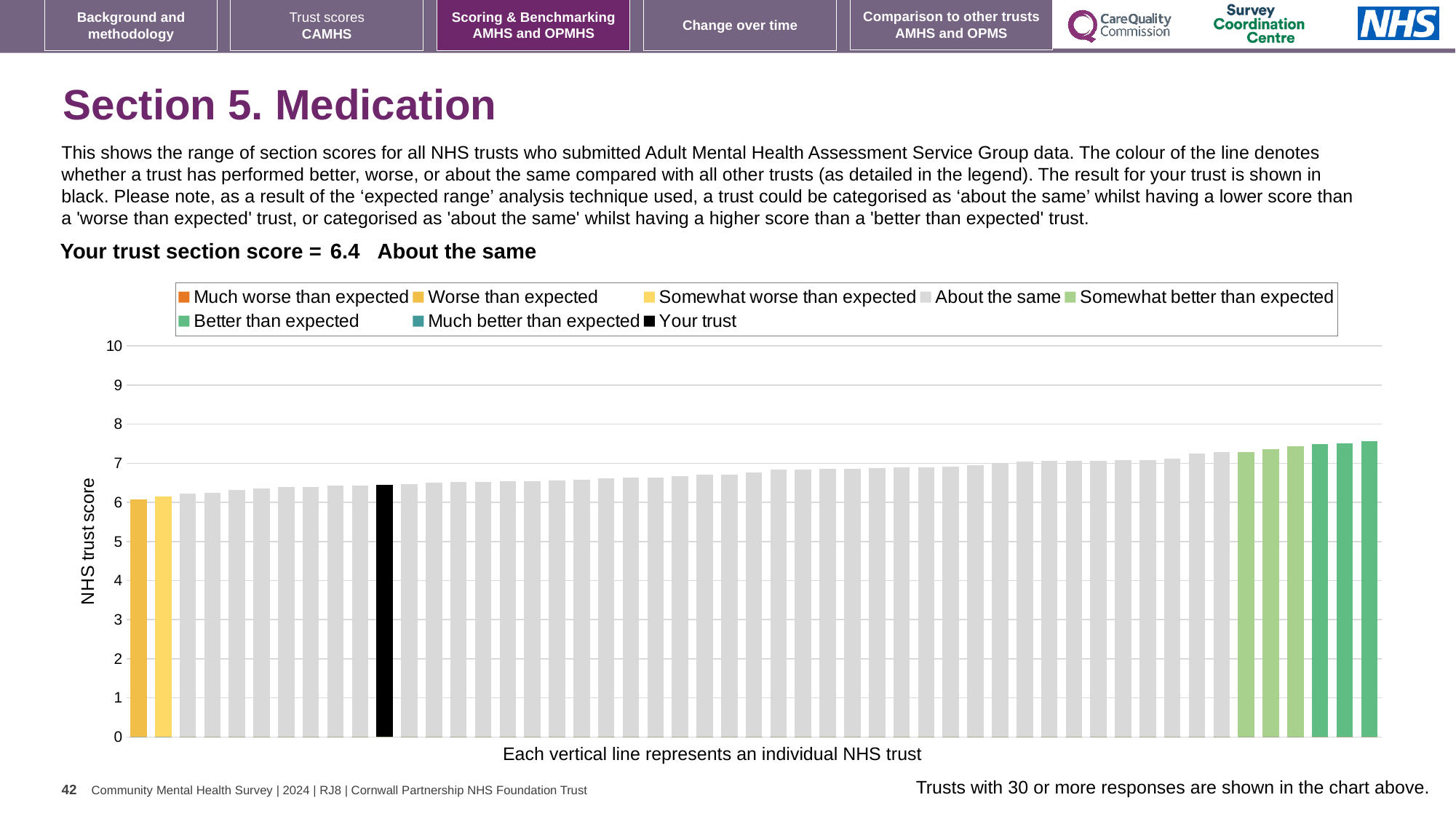
What is the label on the vertical axis of the chart? NHS trust score Is the value of the shortest bar in the chart greater or less than 5? greater How many bars are coloured in the 'Worse than expected' yellow shade? 1 Is the value of the tallest bar in the chart greater or less than 8? less What type of chart is shown on the slide? bar chart Is the value for your trust (the black bar) greater or less than 7? less Do the bar values rise or fall from left to right across the chart? rise What is the section score for your trust shown on the slide? 6.4 Which category is your trust's section score placed in? About the same What does each vertical line in the chart represent, according to the caption below the x axis? an individual NHS trust How many entries does the chart legend list? 8 Which is larger: the black 'Your trust' bar or the leftmost bar in the chart? the black 'Your trust' bar